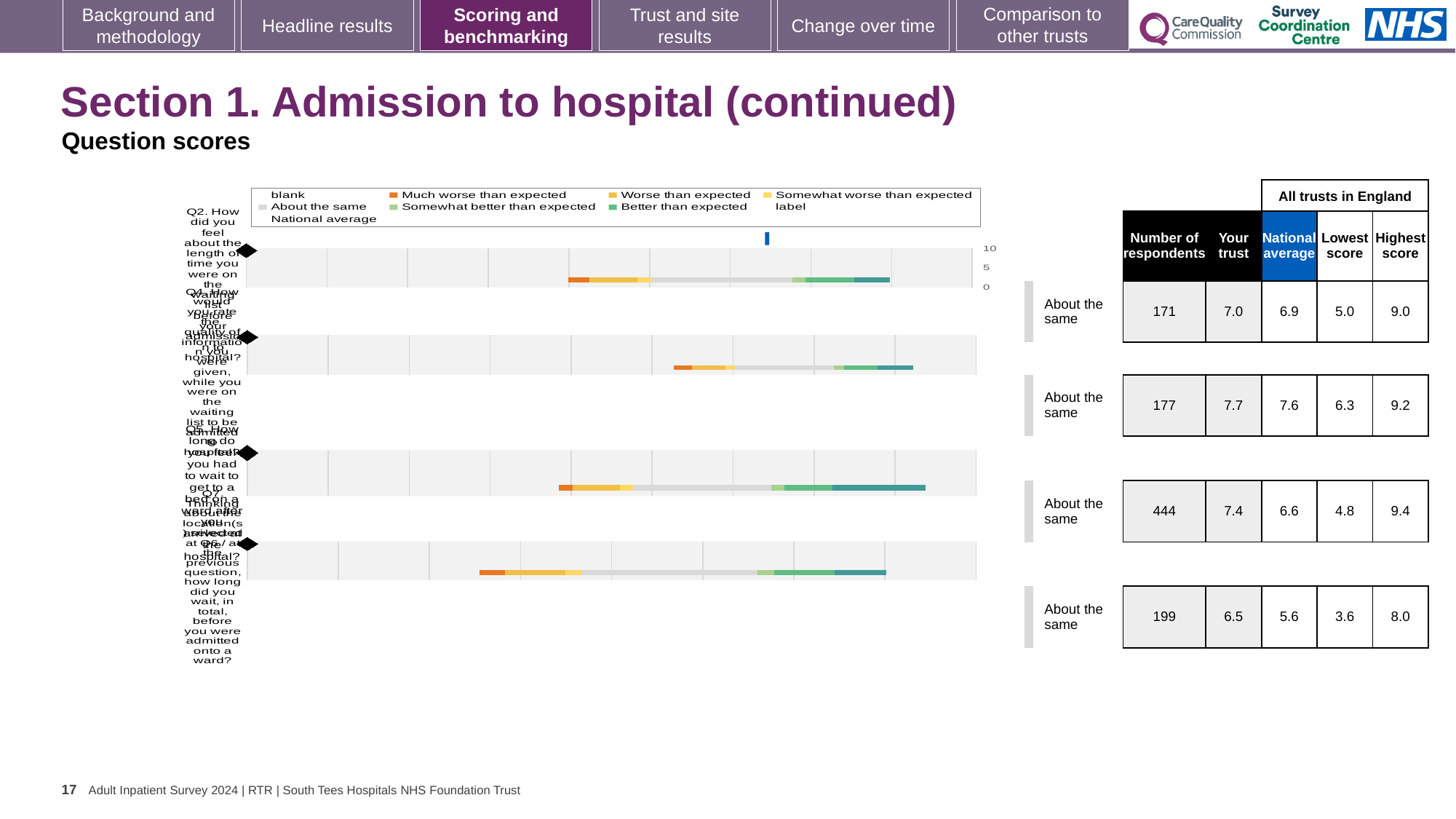
For the first row (Q2), which is larger: the 'Your trust' score or the national average? Your trust (7.0) What is the 'Your trust' score for the second row (Q4)? 7.7 How many question rows are plotted in the chart? 4 For the second row (Q4), what is the difference between the highest score and the lowest score? 2.9 For the third row (Q5), what is the difference between the 'Your trust' score and the national average? 0.8 What is the lowest score among all trusts in England for the third row (Q5)? 4.8 Which row has the lowest 'Your trust' score? Q7 (fourth row), 6.5 What is the number of respondents for the first row (Q2)? 171 What kind of chart is shown on the slide? bar chart What benchmark category is shown next to each of the four question rows? About the same What is the highest score among all trusts in England for the fourth row (Q7)? 8.0 Which row has the highest number of respondents? Q5 (third row), 444